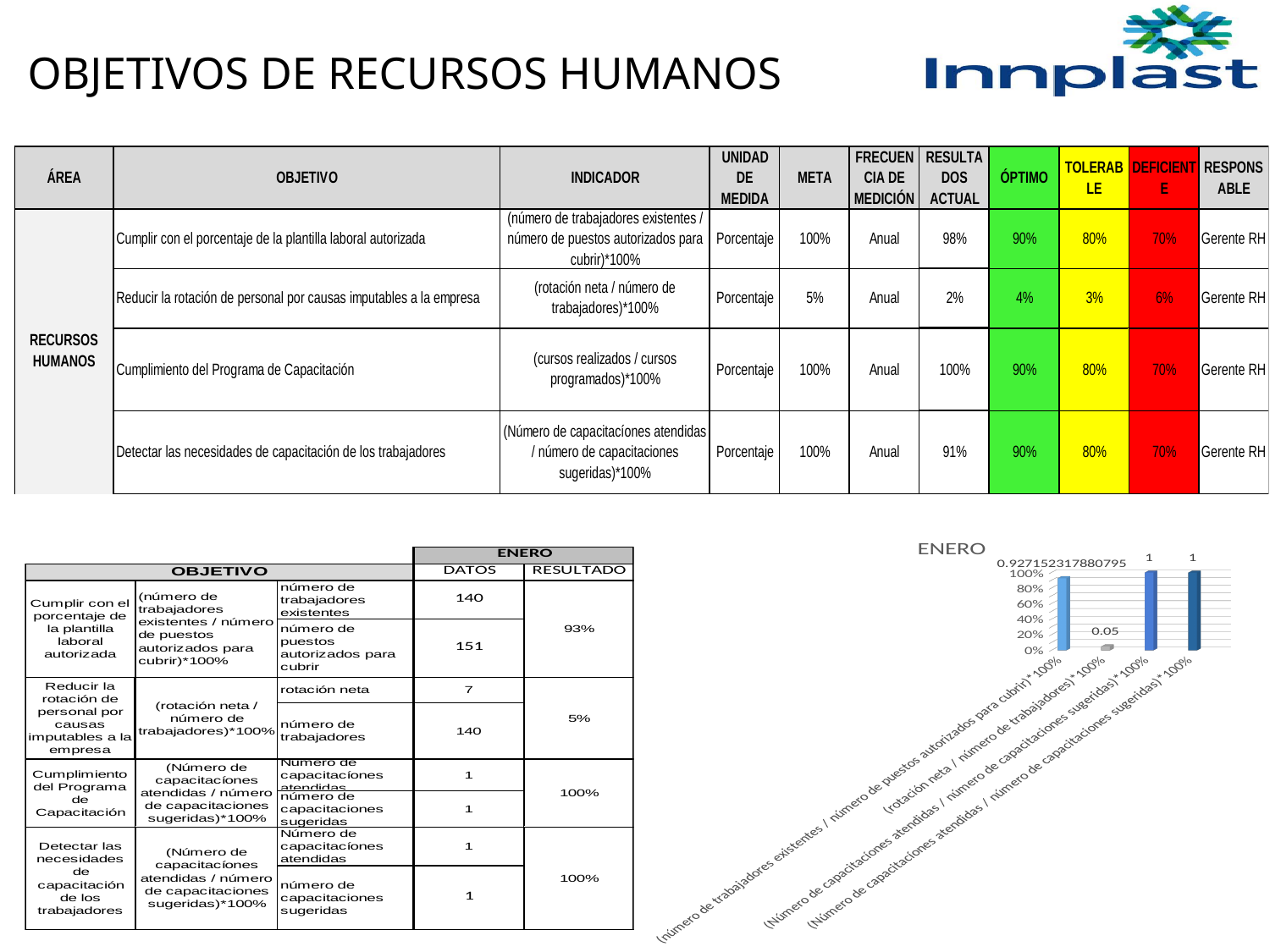
In the ENERO chart, which is larger: the bar for '(número de trabajadores existentes / número de puestos autorizados para cubrir)*100%' or the bar for '(rotación neta / número de trabajadores)*100%'? (número de trabajadores existentes / número de puestos autorizados para cubrir)*100% In the ENERO chart, is the bar for '(número de trabajadores existentes / número de puestos autorizados para cubrir)*100%' greater or less than 80%? greater What is the title of the chart on the slide? ENERO How many bars are plotted in the ENERO chart? 4 In the ENERO chart, which category has the lowest bar? (rotación neta / número de trabajadores)*100% In the ENERO chart, what value is labelled on the bars for '(Número de capacitaciones atendidas / número de capacitaciones sugeridas)*100%'? 1 In the ENERO chart, what is the value labelled on the bar for '(número de trabajadores existentes / número de puestos autorizados para cubrir)*100%'? 0.927152317880795 What kind of chart is shown on the slide? bar chart In the ENERO chart, what is the difference between the labelled value 1 for '(Número de capacitaciones atendidas / número de capacitaciones sugeridas)*100%' and the value 0.05 for '(rotación neta / número de trabajadores)*100%'? 0.95 What is the highest tick value shown on the vertical axis of the ENERO chart? 100% In the ENERO chart, what is the value labelled on the bar for '(rotación neta / número de trabajadores)*100%'? 0.05 In the ENERO chart, is the bar for '(rotación neta / número de trabajadores)*100%' greater or less than 20%? less